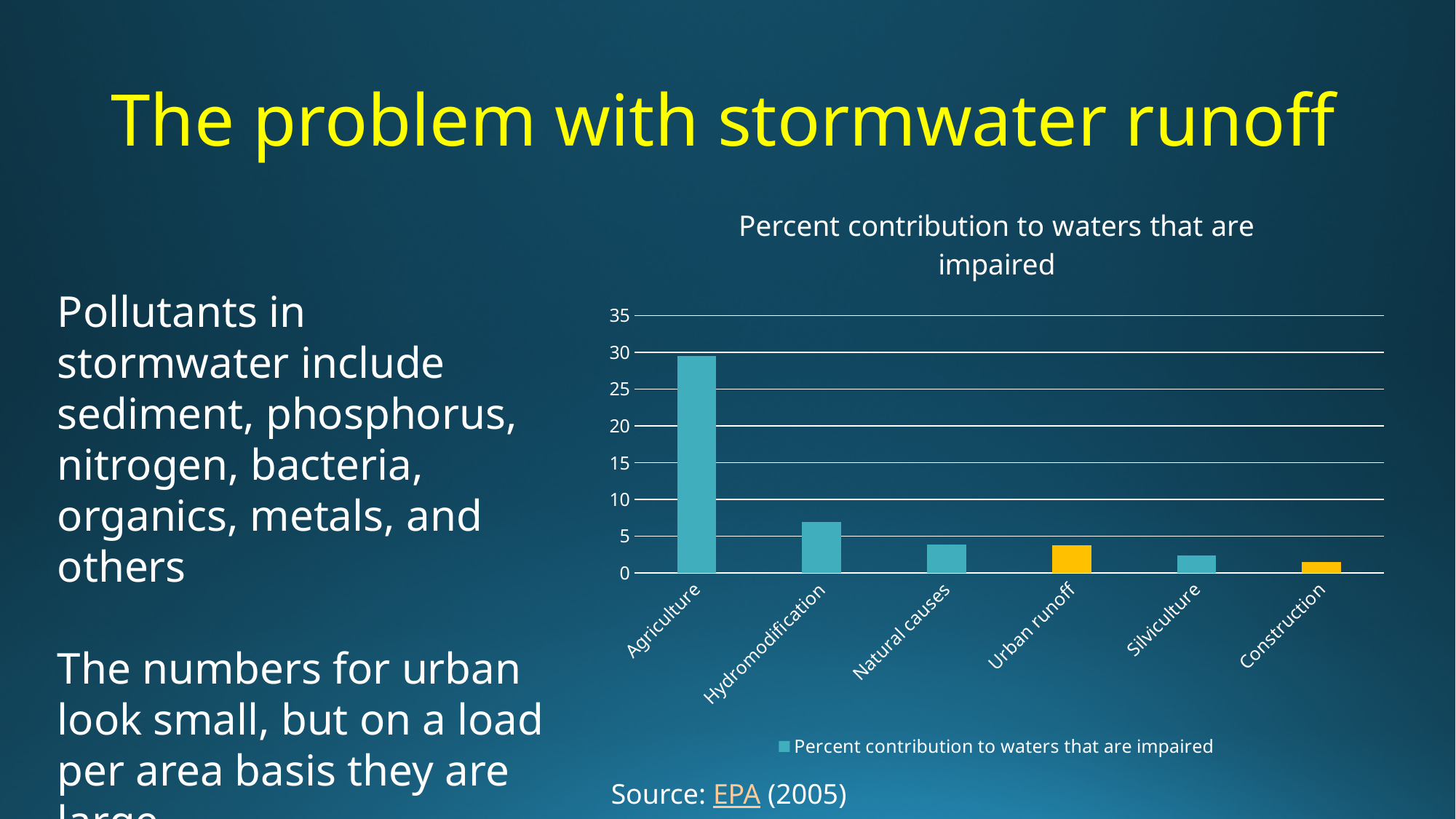
Is the value for Silviculture greater or less than 5? less What type of chart is shown on the slide? bar chart Which category has the highest percent contribution to waters that are impaired? Agriculture Which category has the lowest percent contribution to waters that are impaired? Construction Which is larger, the value for Agriculture or the value for Hydromodification? Agriculture What is the title of the chart? Percent contribution to waters that are impaired Do the values generally rise or fall moving from left to right along the x axis? fall Is the value for Agriculture greater or less than 25? greater Is the value for Hydromodification greater or less than 10? less How many categories are shown on the x axis of the chart? 6 How many series does the chart legend list? 1